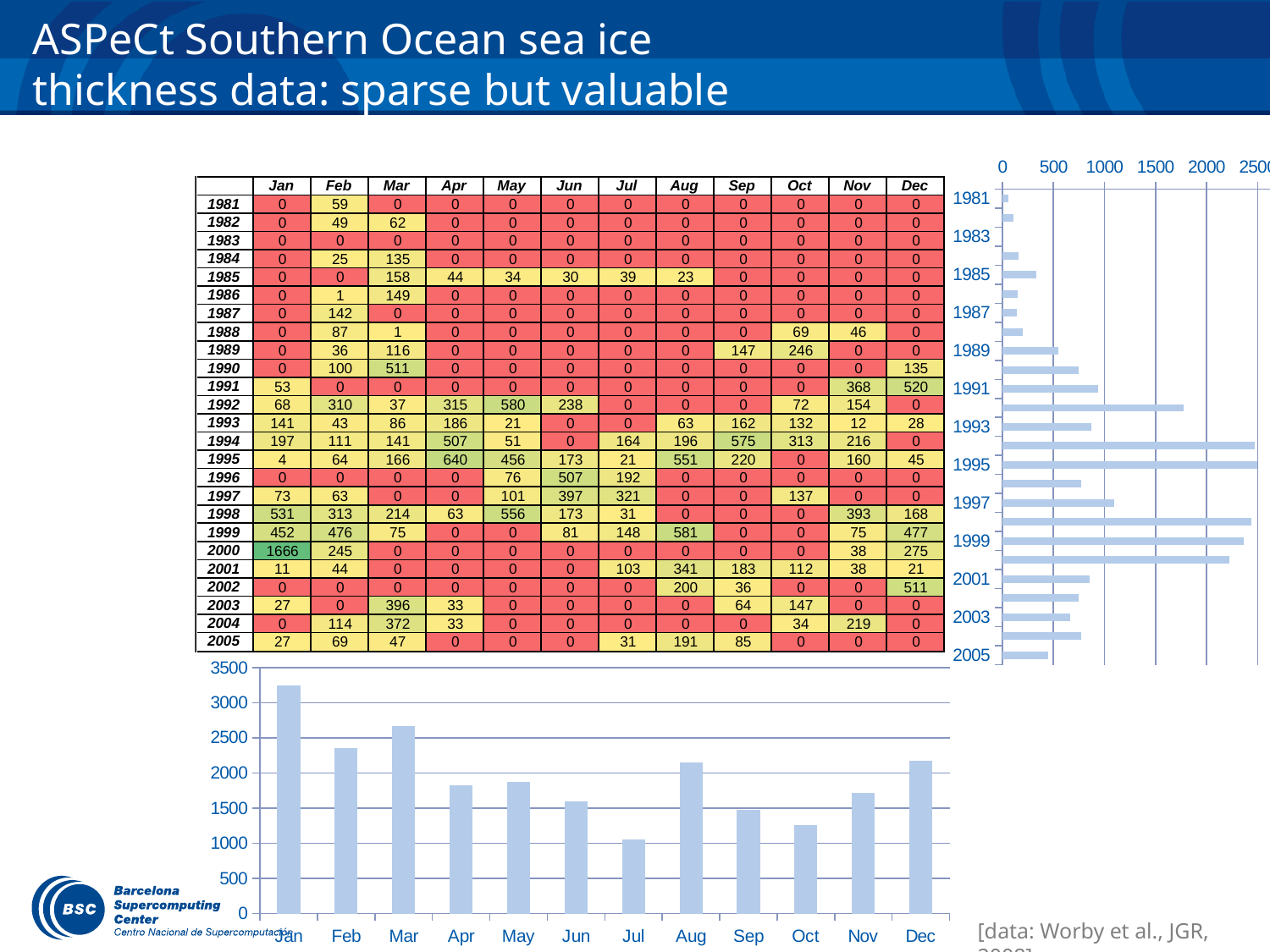
In the bottom chart, is the value for Mar greater or less than 2500? greater In the chart on the right side of the slide, which is larger, the value for 1983 or the value for 1985? 1985 What is the highest tick value shown on the vertical axis of the bottom chart? 3500 In the bottom chart, is the value for Oct greater or less than 1500? less In the bottom chart, is the value for Jan greater or less than 3000? greater In the bottom chart, which is larger, the value for Aug or the value for Sep? Aug How many months are plotted in the bottom chart? 12 In the bottom chart, which month has the lowest value? Jul What kind of chart is the chart at the bottom of the slide? bar chart In the bottom chart, which month has the highest value? Jan In the chart on the right side of the slide, which year has the lowest value? 1983